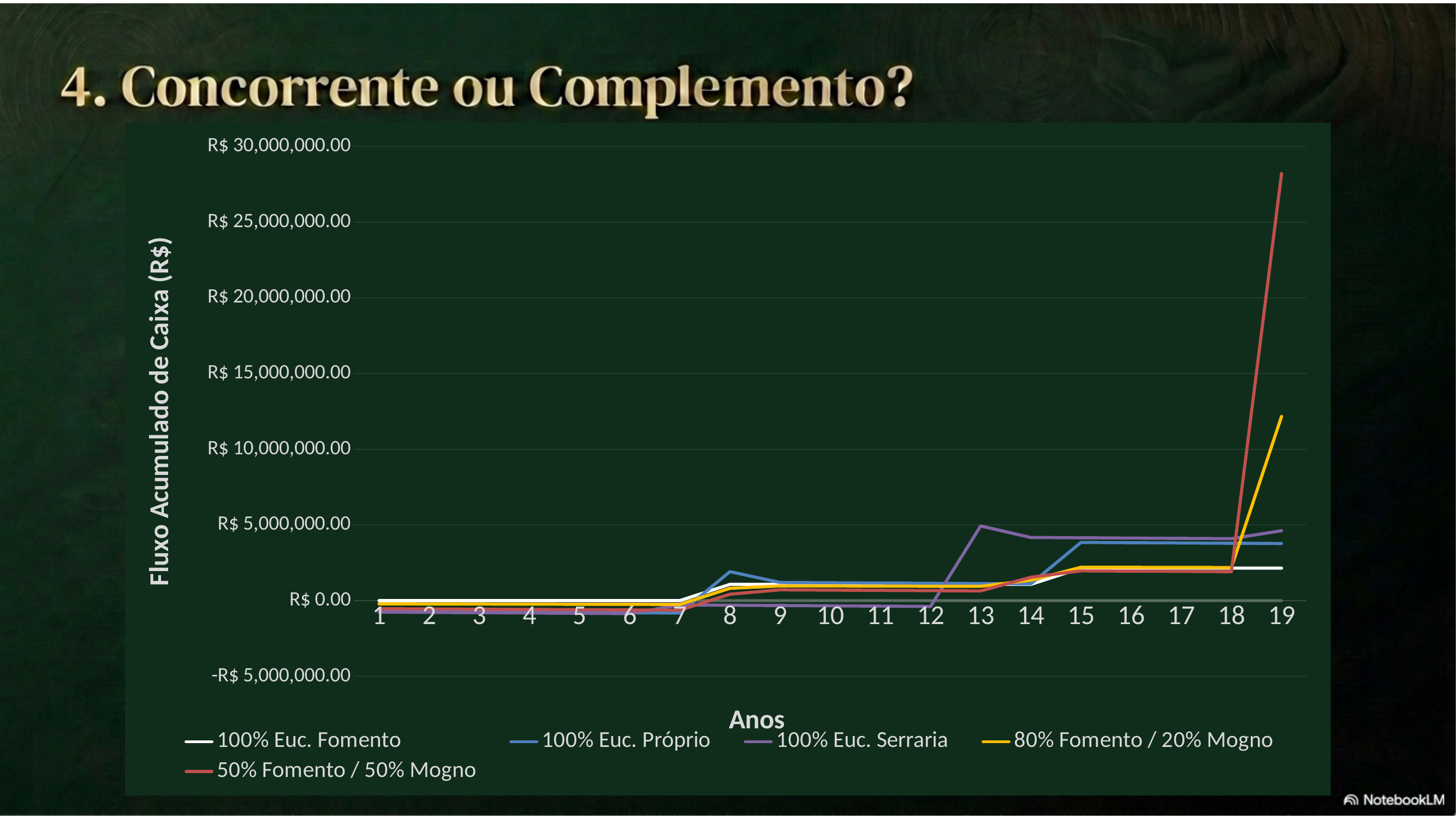
At year 19, which is larger: 80% Fomento / 20% Mogno or 100% Euc. Fomento? 80% Fomento / 20% Mogno Does the 50% Fomento / 50% Mogno series rise or fall from year 18 to year 19? rise Is the value for 80% Fomento / 20% Mogno at year 19 greater or less than R$ 10,000,000.00? greater Is the value for 50% Fomento / 50% Mogno at year 19 greater or less than R$ 25,000,000.00? greater What kind of chart is shown on the slide? line chart At year 13, which is larger: 100% Euc. Serraria or 100% Euc. Próprio? 100% Euc. Serraria Is the value for 100% Euc. Próprio at year 19 greater or less than R$ 5,000,000.00? less Which series has the highest value at year 19? 50% Fomento / 50% Mogno Which series has the lowest value at year 19? 100% Euc. Fomento How many years are plotted along the x axis? 19 How many series does the legend list? 5 What is the title of the y axis? Fluxo Acumulado de Caixa (R$)